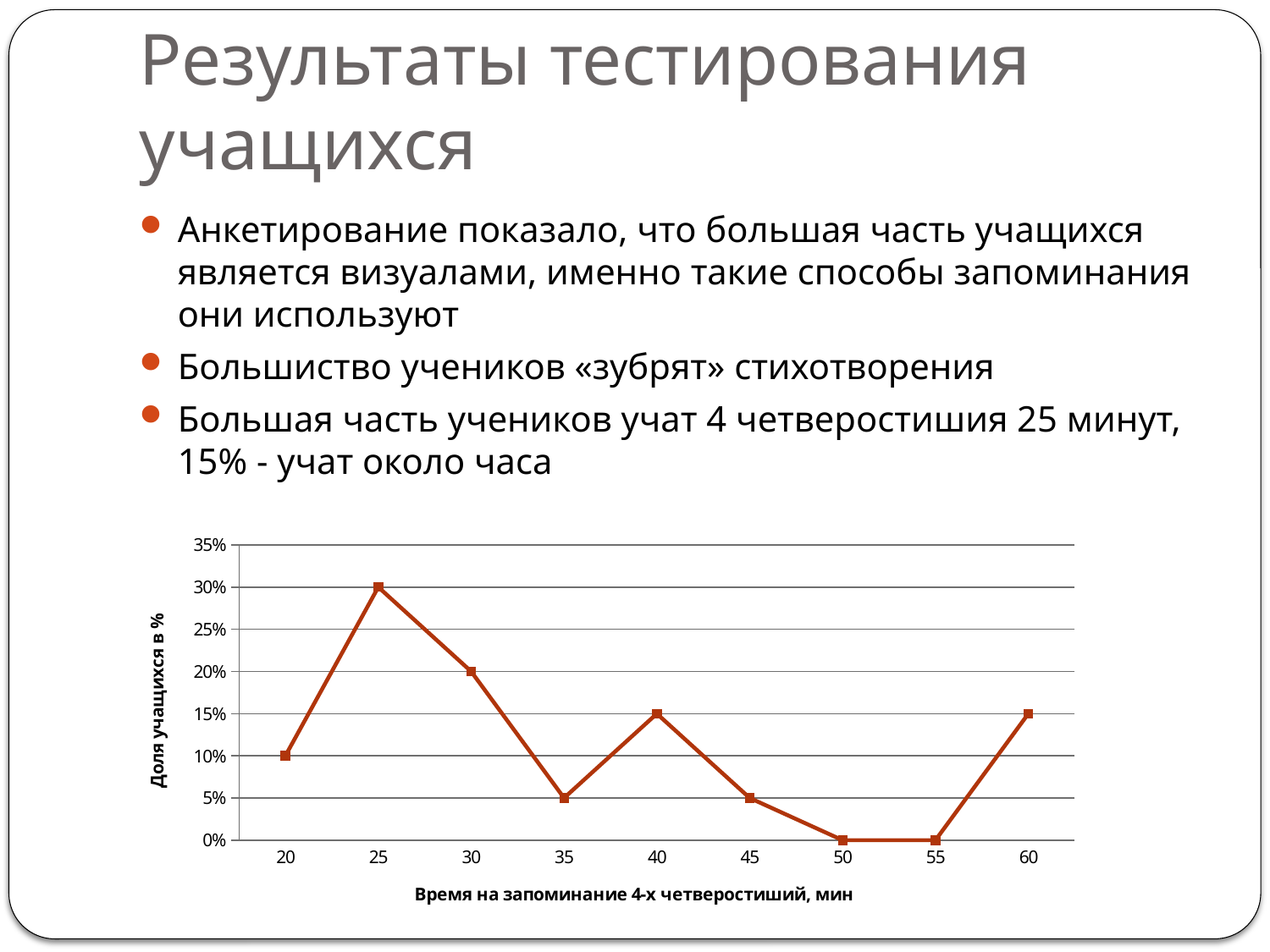
How many data points are plotted on the chart? 9 What is the difference between the share for 25 minutes and the share for 20 minutes? 20% What is the share of students for 25 minutes? 30% Is the value for 35 minutes greater or less than 10%? less What is the share of students for 30 minutes? 20% Which has a larger share of students: 40 minutes or 45 minutes? 40 minutes At which time (in minutes) is the share of students highest? 25 What is the share of students for 50 minutes? 0% What is the label of the x axis? Время на запоминание 4-х четверостиший, мин What kind of chart is shown on the slide? line chart What is the share of students for 60 minutes? 15% Does the share of students rise or fall between 25 and 35 minutes? fall